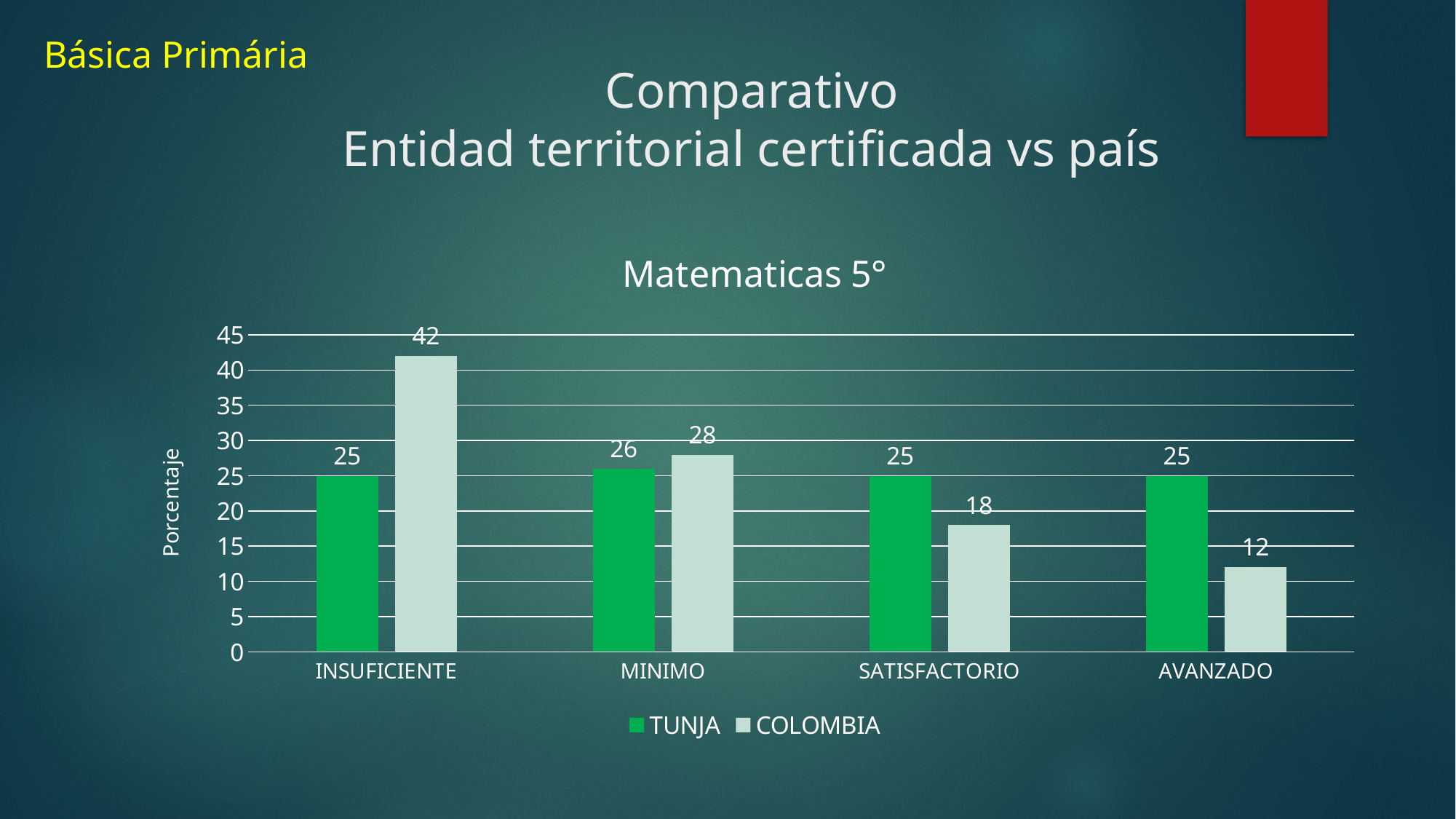
Which category has the highest value for COLOMBIA? INSUFICIENTE What is the value for COLOMBIA in the AVANZADO category? 12 In the AVANZADO category, which series has the larger value, TUNJA or COLOMBIA? TUNJA What is the value for TUNJA in the INSUFICIENTE category? 25 What is the value for TUNJA in the MINIMO category? 26 What is the difference between the TUNJA and COLOMBIA values in the SATISFACTORIO category? 7 What is the value for COLOMBIA in the INSUFICIENTE category? 42 Which category has the lowest value for COLOMBIA? AVANZADO How many categories are shown on the x axis? 4 What type of chart is shown on the slide? Bar chart What is the difference between the COLOMBIA and TUNJA values in the INSUFICIENTE category? 17 How many series does the legend list? 2